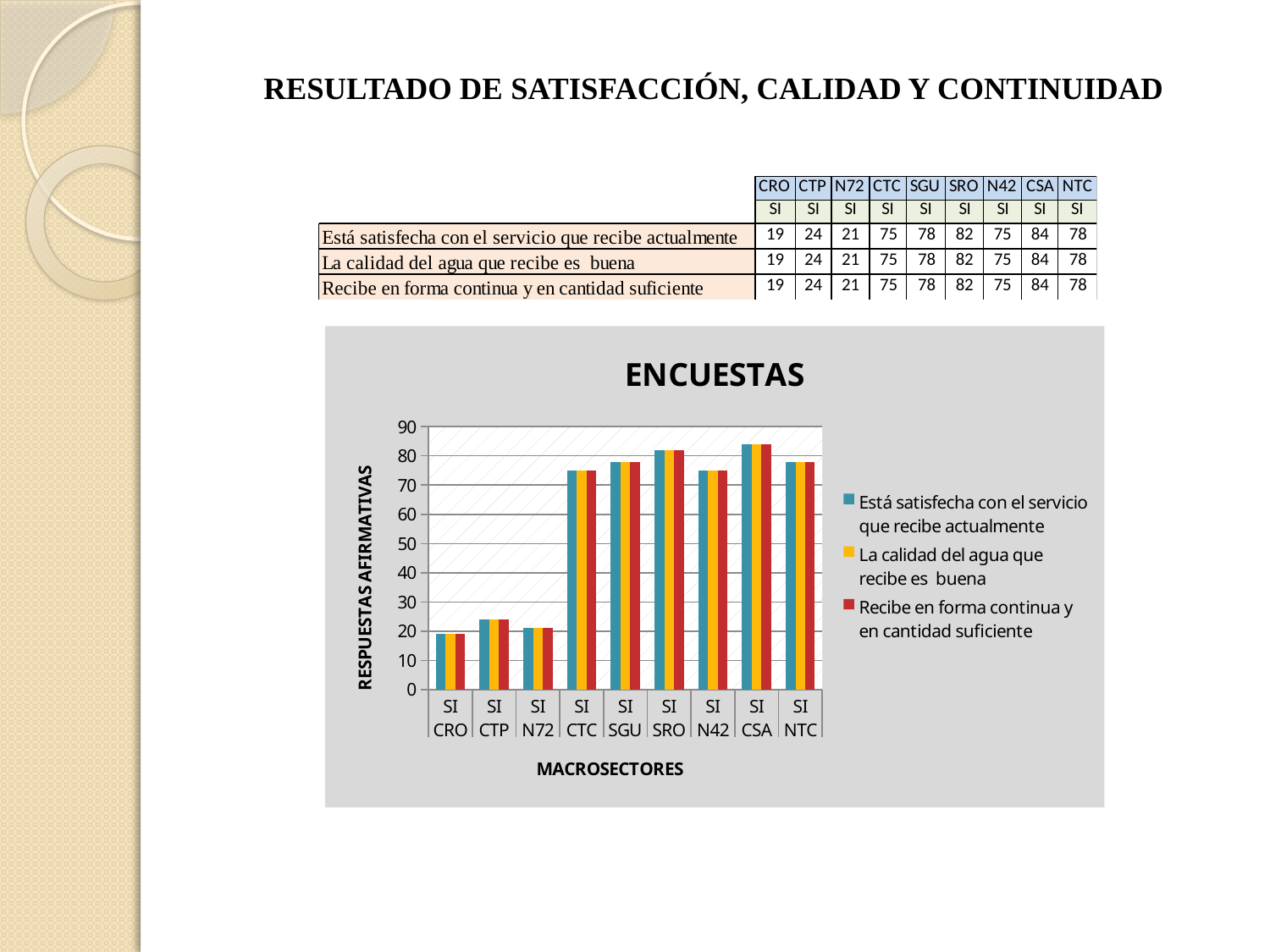
How many series does the legend of the ENCUESTAS chart list? 3 What is the value for SRO for the series 'Recibe en forma continua y en cantidad suficiente'? 82 How many macrosectores (categories) are shown on the x axis of the ENCUESTAS chart? 9 What is the label of the y axis of the ENCUESTAS chart? RESPUESTAS AFIRMATIVAS Is the value for CTP greater or less than 30 in the ENCUESTAS chart? less What is the value for CSA for the series 'Está satisfecha con el servicio que recibe actualmente'? 84 What type of chart is shown under the title ENCUESTAS? bar chart Which is larger in the ENCUESTAS chart, the value for SGU or the value for N72? SGU What is the difference between the values for CSA and CRO for 'Está satisfecha con el servicio que recibe actualmente'? 65 Which macrosector has the highest value in the ENCUESTAS chart? CSA Which macrosector has the lowest value in the ENCUESTAS chart? CRO What is the value for CRO for the series 'La calidad del agua que recibe es buena'? 19